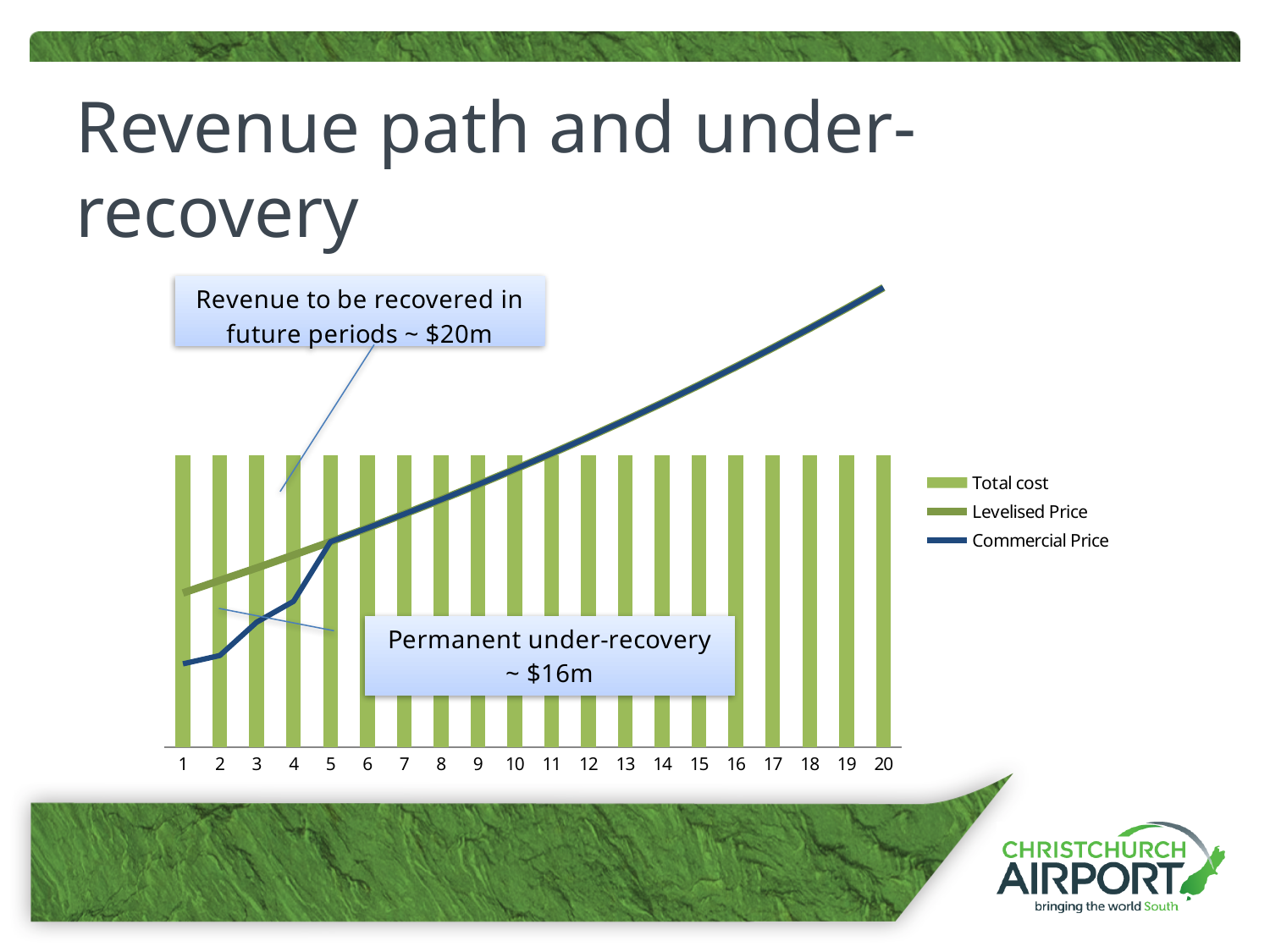
How many periods are shown on the x axis of the chart? 20 At which period is the Commercial Price line at its highest? 20 Does the Commercial Price line rise or fall from period 1 to period 20? Rises How many series does the chart legend list? 3 According to the annotation on the chart, approximately how large is the permanent under-recovery? ~ $16m At which period is the Commercial Price line at its lowest? 1 According to the annotation on the chart, approximately how much revenue is to be recovered in future periods? ~ $20m What kind of chart is shown on the slide? Combined bar and line chart At period 20, is the Commercial Price line above or below the top of the Total cost bar? Above At period 1, which is higher: the Levelised Price or the Commercial Price? Levelised Price Which series in the chart is drawn as bars? Total cost